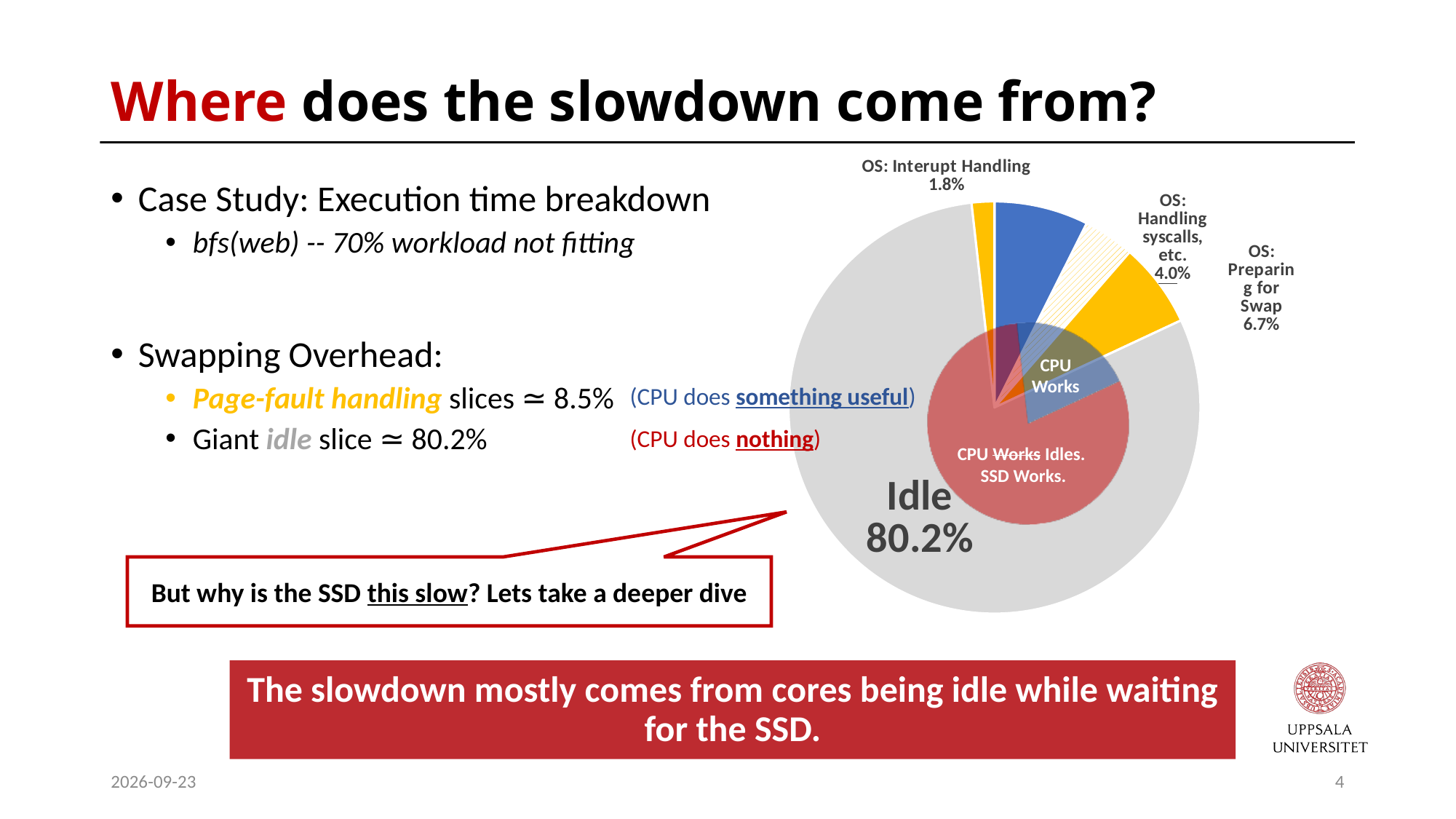
What is the difference in percentage points between the 'OS: Preparing for Swap' slice (6.7%) and the 'OS: Handling syscalls, etc.' slice (4.0%)? 2.7 percentage points What colour is the 'OS: Preparing for Swap' slice in the pie chart? Yellow Which slice is larger: 'OS: Preparing for Swap' or 'OS: Handling syscalls, etc.'? OS: Preparing for Swap Which of the labelled slices with a printed percentage is the smallest? OS: Interupt Handling What percentage is shown for the 'OS: Interupt Handling' slice? 1.8% What colour is the Idle slice in the pie chart? Grey What percentage is shown for the 'OS: Handling syscalls, etc.' slice? 4.0% Which slice of the pie chart is the largest? Idle What share of execution time does the Idle slice represent in the pie chart? 80.2% What is the combined share of the three OS slices (Interupt Handling, Handling syscalls, Preparing for Swap)? 12.5% What kind of chart is shown on the slide? Pie chart What percentage is shown for the 'OS: Preparing for Swap' slice? 6.7%